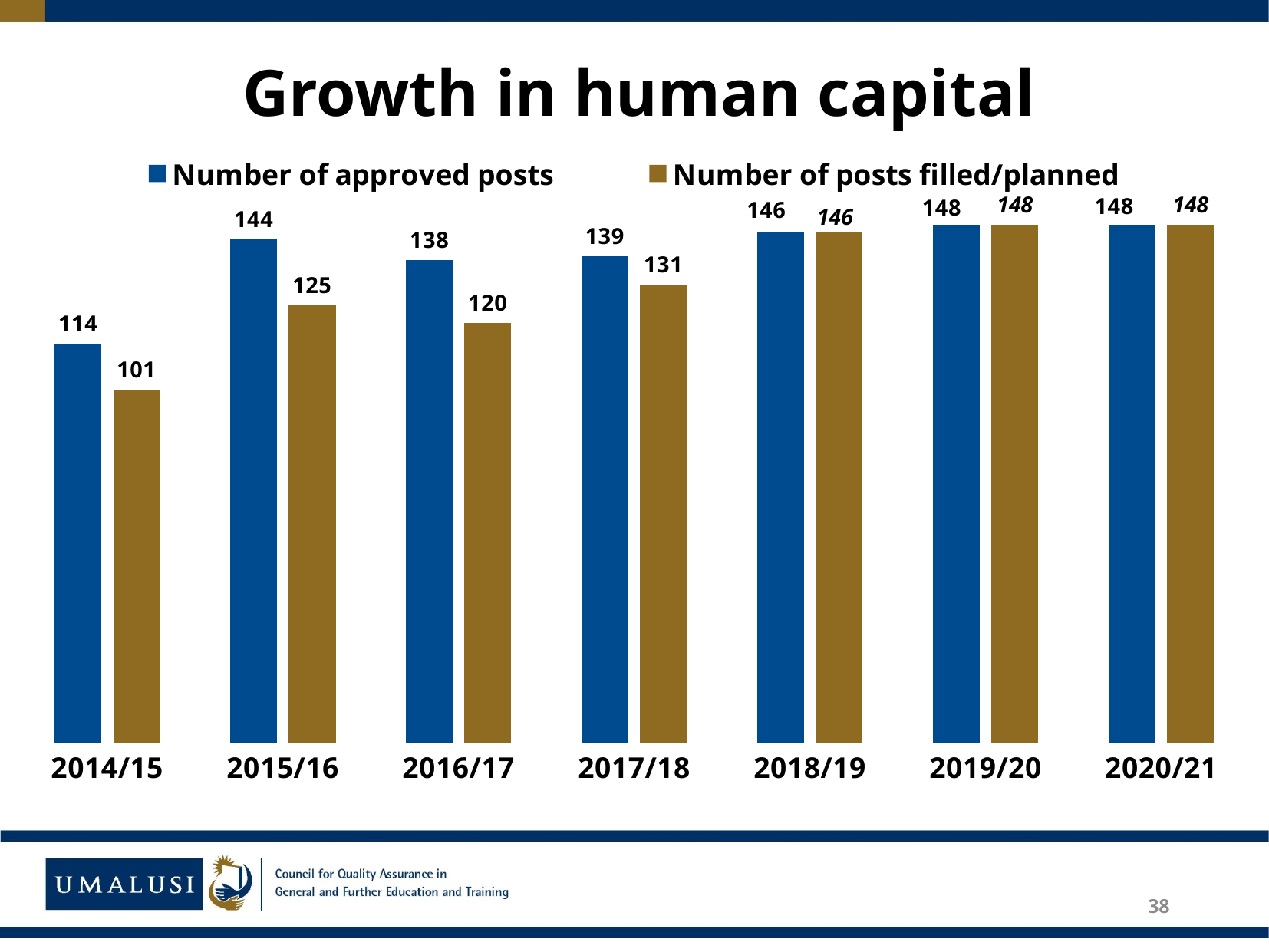
How many years are shown on the x axis? 7 Which year has the lowest number of posts filled/planned? 2014/15 What kind of chart is shown on the slide? Bar chart How many series does the legend list? 2 Which year has the highest number of approved posts? 2019/20 and 2020/21 What is the difference between the number of approved posts and the number of posts filled/planned in 2015/16? 19 Which is larger in 2017/18: the number of approved posts or the number of posts filled/planned? Number of approved posts What is the title of the slide? Growth in human capital Does the number of posts filled/planned generally rise or fall from 2014/15 to 2020/21? Rise What is the number of posts filled/planned in 2016/17? 120 What is the number of approved posts in 2017/18? 139 What is the number of approved posts in 2014/15? 114